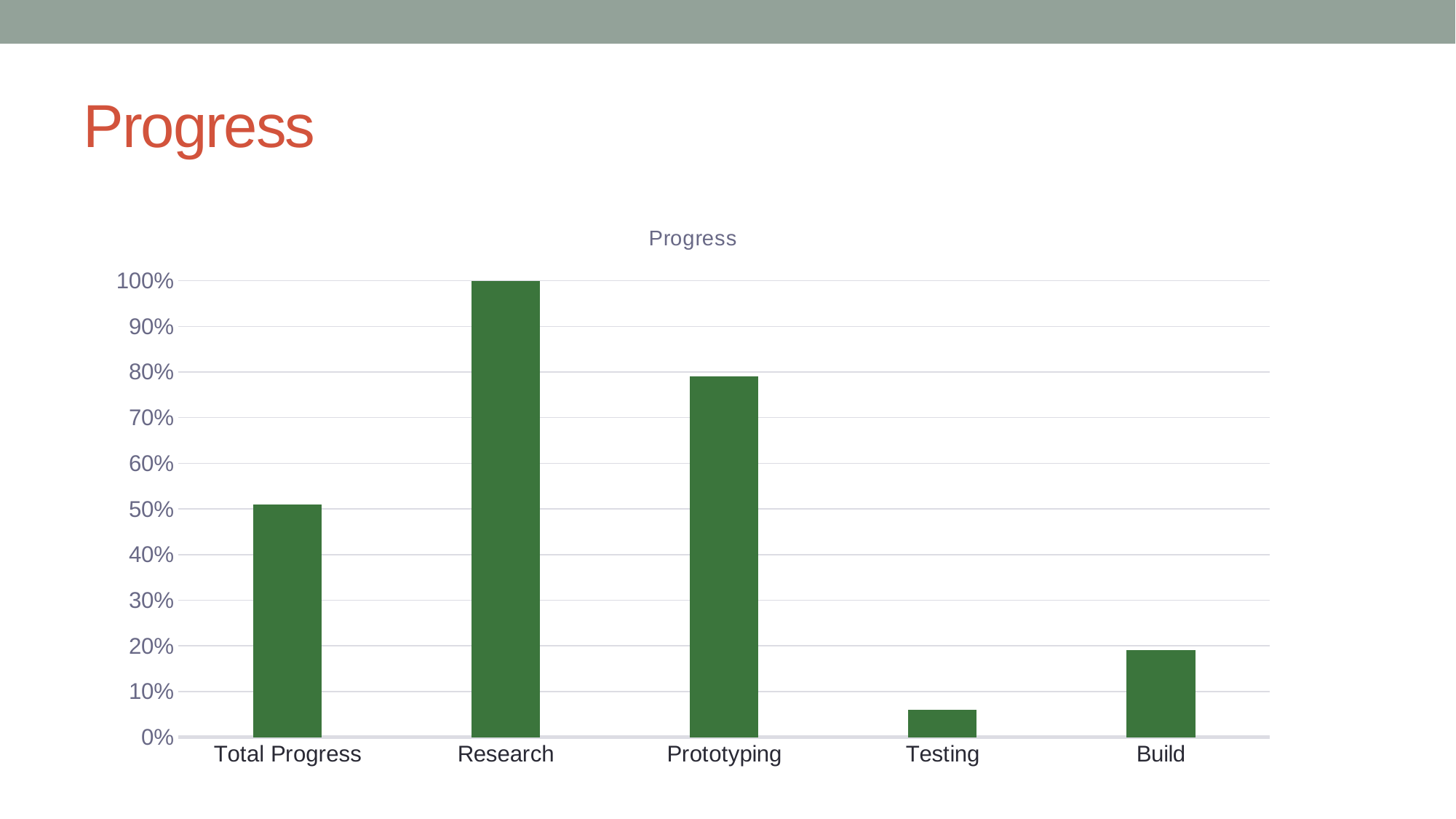
Is the value for Build greater or less than 10%? greater Which is larger, the value for Prototyping or the value for Total Progress? Prototyping Which category has the highest value in the chart? Research How many categories are shown on the x axis of the chart? 5 Is the value for Total Progress greater or less than 60%? less What is the title of the chart? Progress What kind of chart is shown on the slide? bar chart Which category has the lowest value in the chart? Testing Is the value for Testing greater or less than 10%? less Which is larger, the value for Build or the value for Testing? Build What is the value for Research? 100%